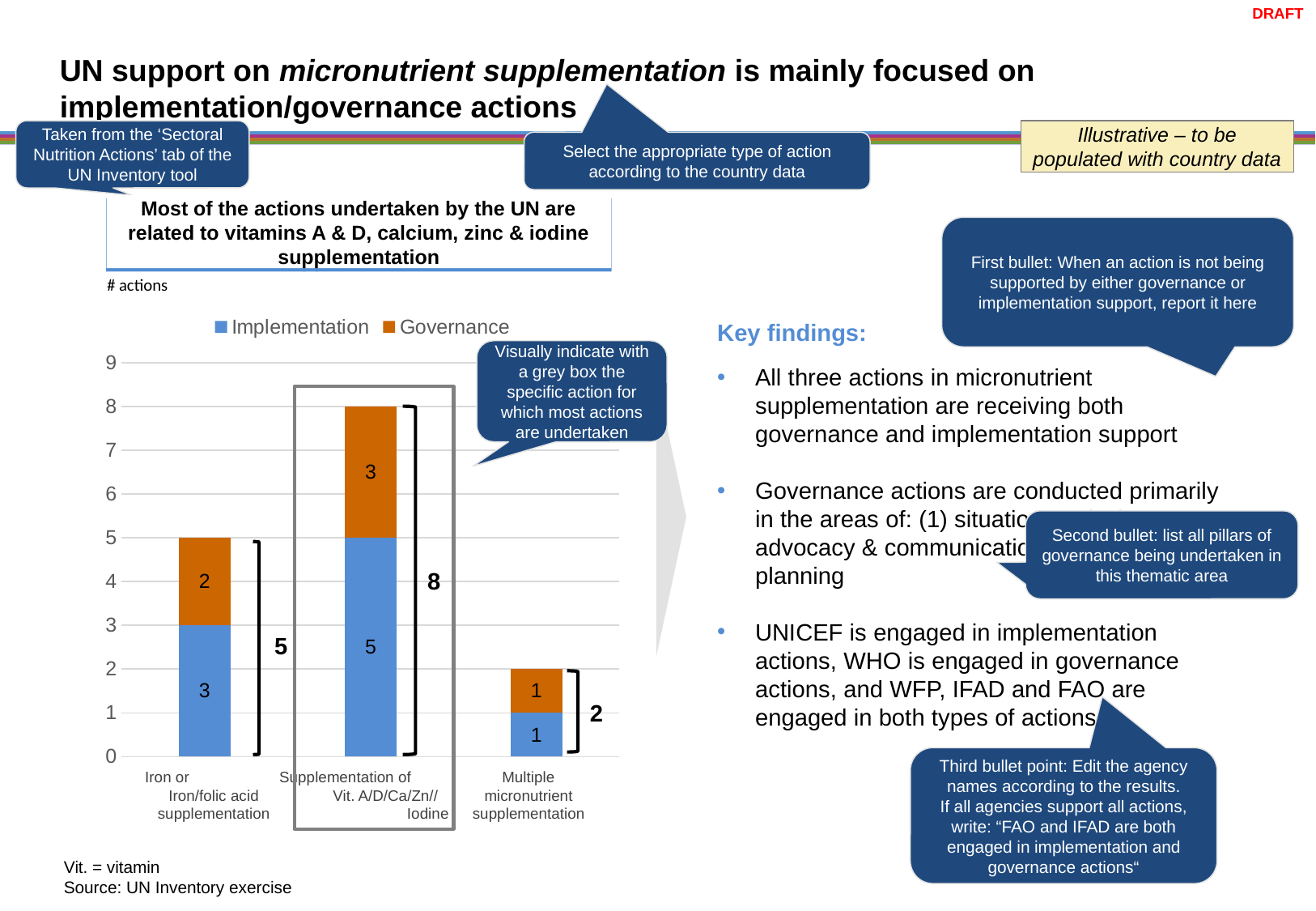
Which category has the lowest total number of actions? Multiple micronutrient supplementation What is the total number of actions for Iron or Iron/folic acid supplementation? 5 Which colour represents the Governance series in the chart? Orange What is the total number of actions for Supplementation of Vit. A/D/Ca/Zn//Iodine? 8 What is the difference between the Implementation values for Supplementation of Vit. A/D/Ca/Zn//Iodine and Iron or Iron/folic acid supplementation? 2 How many categories are shown on the x axis of the chart? 3 What type of chart is shown on the slide? Stacked bar chart What is the Governance value for Supplementation of Vit. A/D/Ca/Zn//Iodine? 3 What is the Implementation value for Iron or Iron/folic acid supplementation? 3 What is the Implementation value for Multiple micronutrient supplementation? 1 Which category has the highest total number of actions? Supplementation of Vit. A/D/Ca/Zn//Iodine How many series does the chart legend list? 2